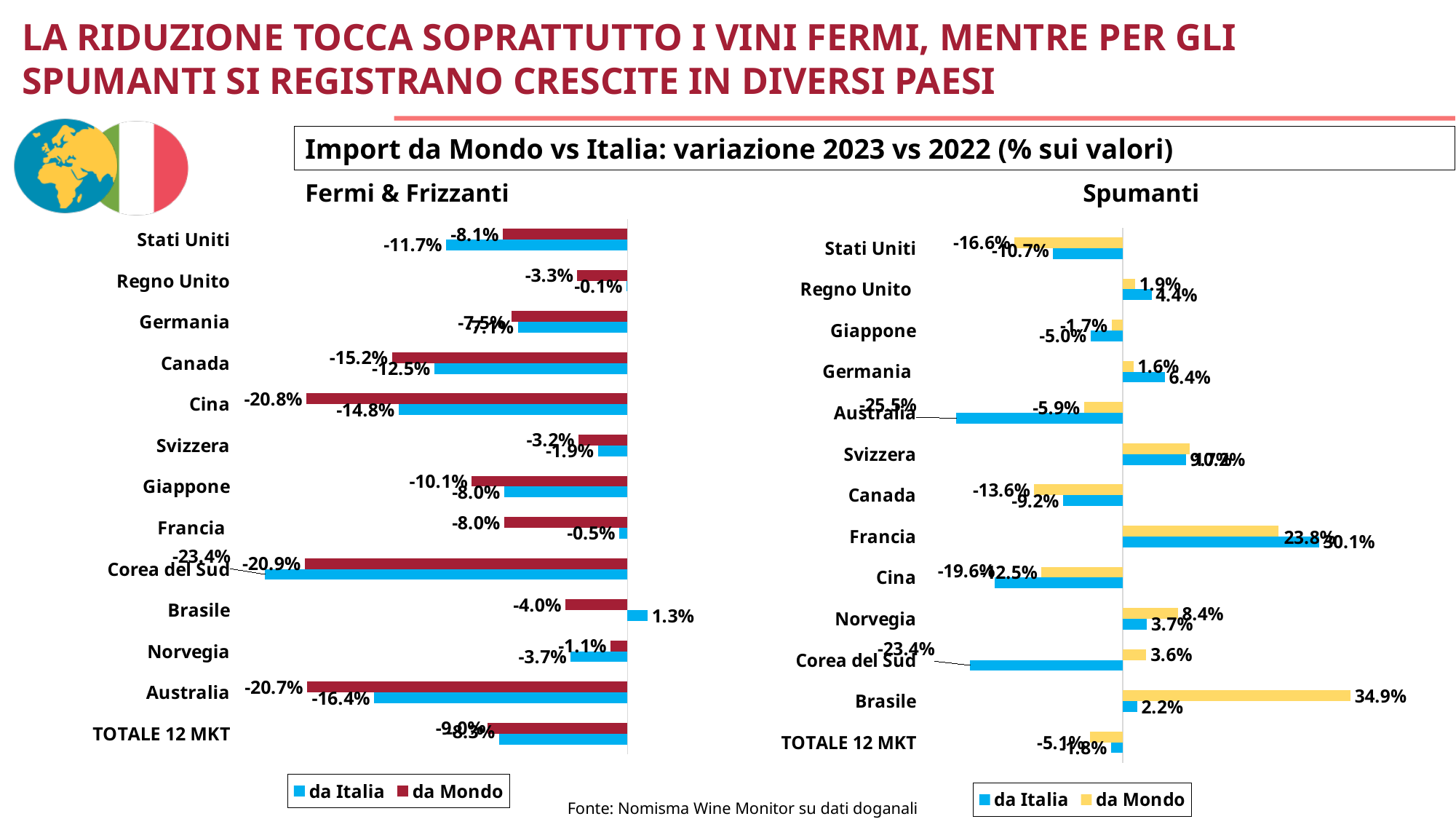
In the Spumanti chart, what is the value for Francia in the da Italia series? 30.1% What type of chart is the Fermi & Frizzanti chart? Bar chart In the Spumanti chart, which category has the lowest da Italia value? Australia In the Spumanti chart, which is larger for Germania: the da Italia value or the da Mondo value? da Italia In the Spumanti chart, what is the value for Brasile in the da Mondo series? 34.9% In the Fermi & Frizzanti chart, which category has the lowest da Mondo value? Corea del Sud In the Spumanti chart, which category has the highest da Mondo value? Brasile In the Fermi & Frizzanti chart, what is the value for Cina in the da Italia series? -14.8% How many series does the legend of the Spumanti chart list? 2 How many categories are shown in the Fermi & Frizzanti chart? 13 In the Fermi & Frizzanti chart, what is the difference between the da Mondo and da Italia values for Francia? 7.5 percentage points In the Fermi & Frizzanti chart, what is the value for Corea del Sud in the da Mondo series? -20.9%